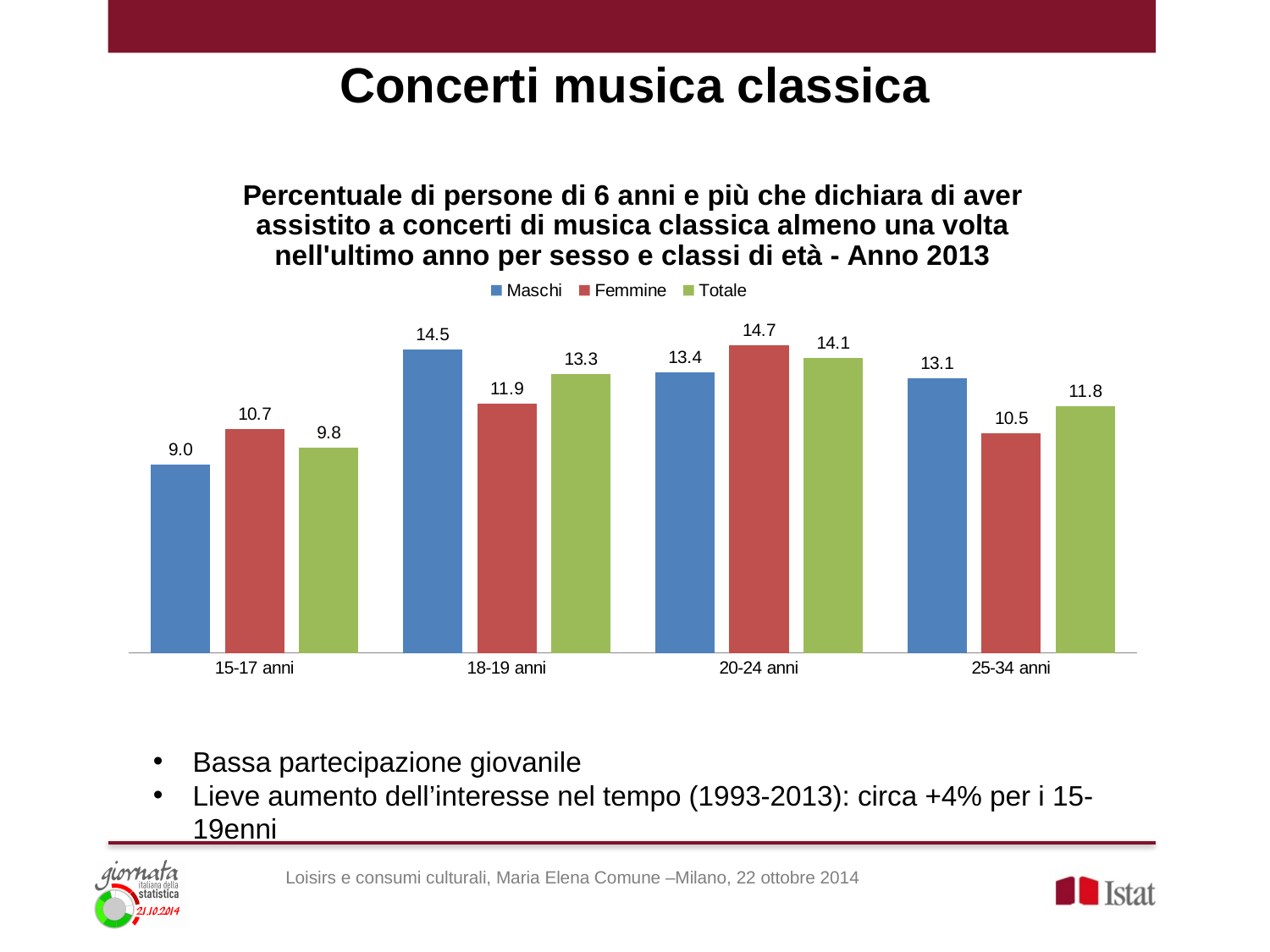
What is the value for Maschi in the 18-19 anni age group? 14.5 What is the difference between the Maschi and Femmine values in the 18-19 anni age group? 2.6 Which series has the highest value in the 20-24 anni age group? Femmine Which colour represents the Totale series in the chart? Green How many series does the legend list? 3 What is the value for Femmine in the 25-34 anni age group? 10.5 In the 15-17 anni age group, which is larger, the Maschi value or the Femmine value? Femmine Which age group has the highest Totale value? 20-24 anni Which age group has the lowest Maschi value? 15-17 anni What kind of chart is shown on the slide? Bar chart What is the Totale value for the 20-24 anni age group? 14.1 How many age groups are shown on the x axis? 4